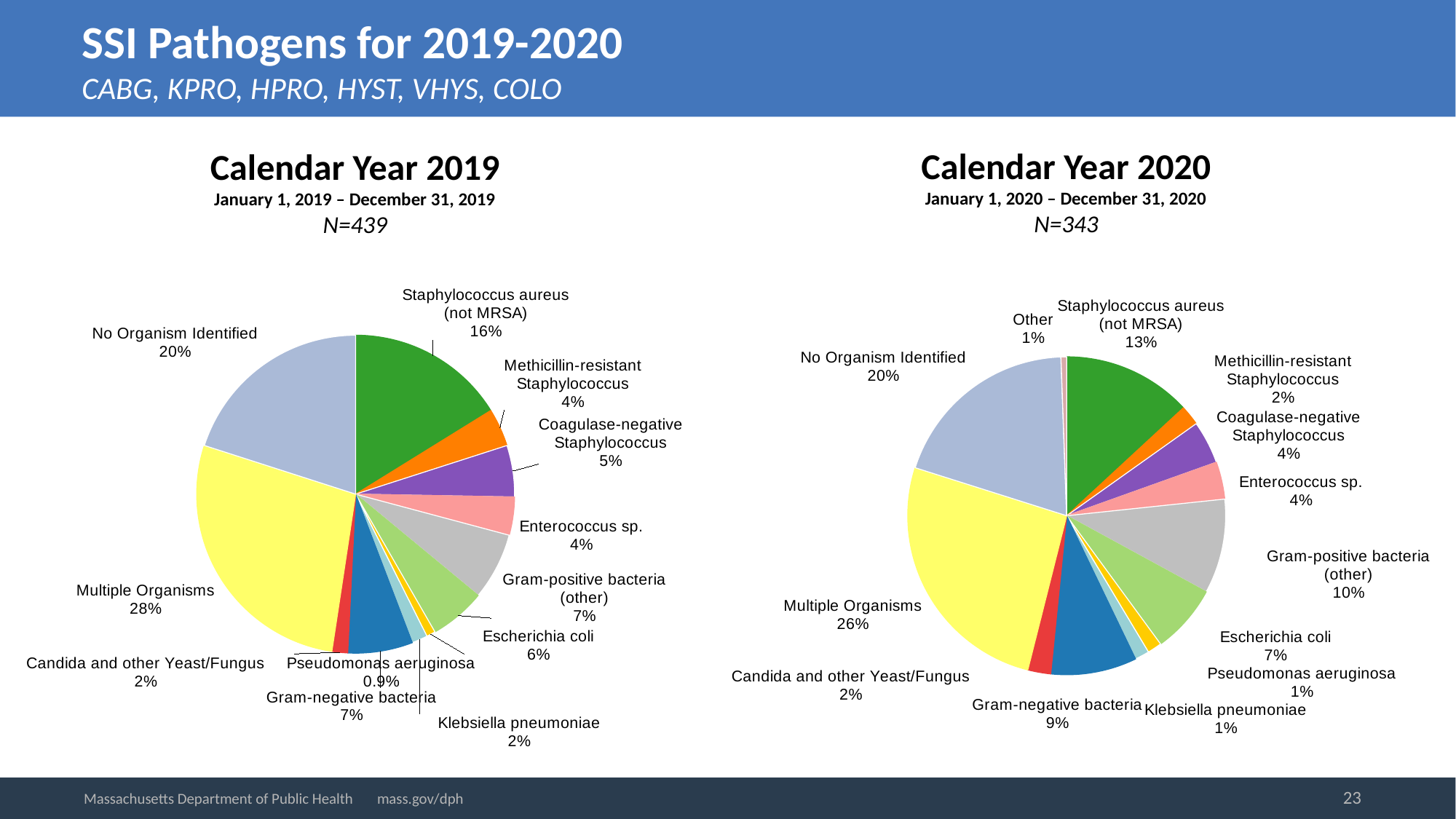
In the Calendar Year 2019 pie chart, what share is labelled for Multiple Organisms? 28% In the Calendar Year 2019 pie chart, which category has the smallest slice? Pseudomonas aeruginosa What is the difference in percentage points between the Multiple Organisms share in the Calendar Year 2019 chart and in the Calendar Year 2020 chart? 2 percentage points In the Calendar Year 2020 pie chart, which category has the largest slice? Multiple Organisms What is the N value shown above the Calendar Year 2020 pie chart? N=343 In the Calendar Year 2020 pie chart, which is larger: the share for Gram-negative bacteria or the share for Escherichia coli? Gram-negative bacteria In the Calendar Year 2020 pie chart, what share is labelled for Staphylococcus aureus (not MRSA)? 13% How many slices does the Calendar Year 2020 pie chart have? 13 In the Calendar Year 2019 pie chart, what share is labelled for Pseudomonas aeruginosa? 0.9% In the Calendar Year 2020 pie chart, what share is labelled for Gram-positive bacteria (other)? 10% In the Calendar Year 2019 pie chart, which category has the largest slice? Multiple Organisms What type of chart is used for Calendar Year 2019? Pie chart